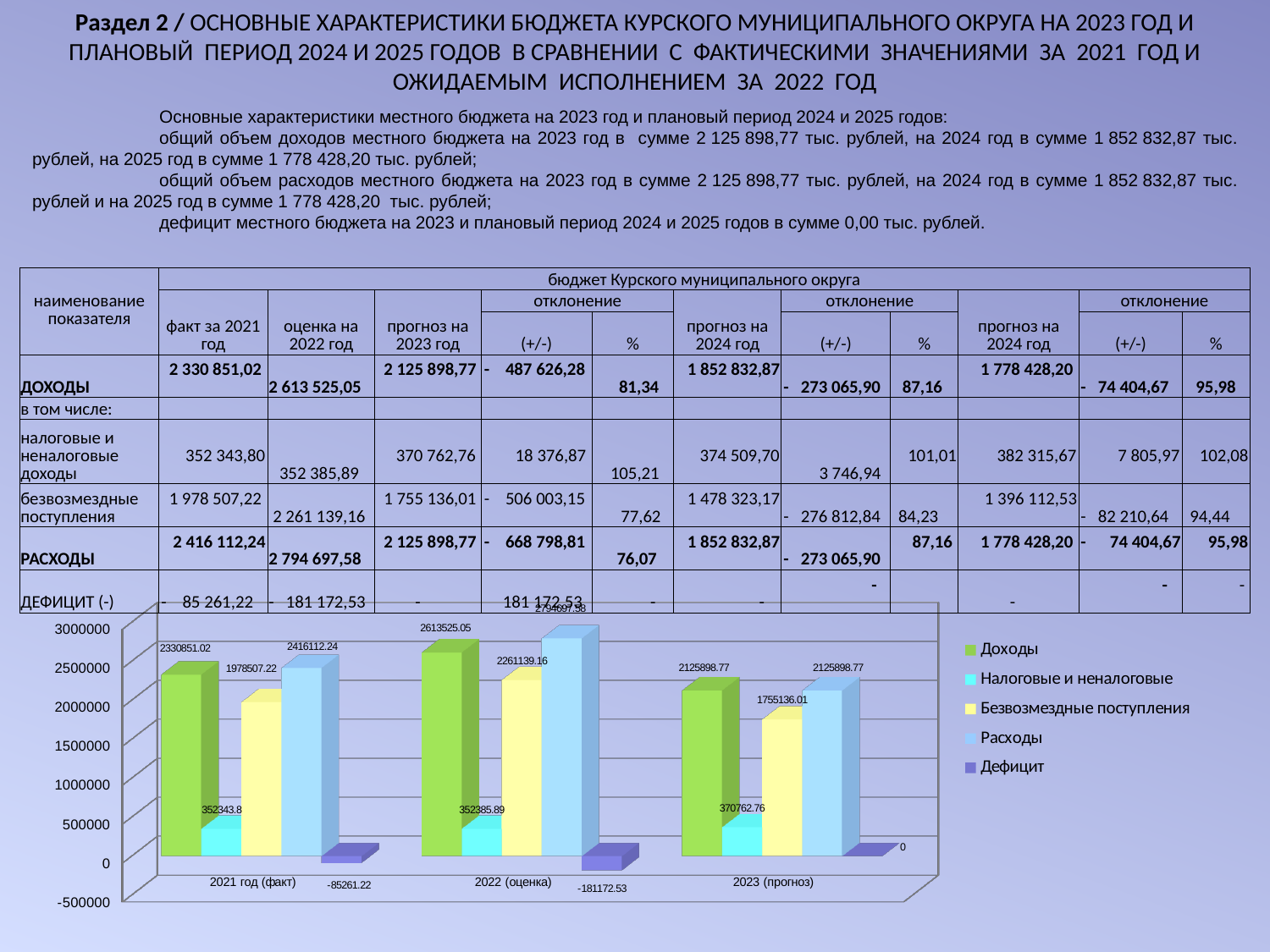
What type of chart is shown at the bottom of the slide? bar chart What is the value of Налоговые и неналоговые for 2023 (прогноз) in the chart? 370762.76 How many categories (years) are shown on the x axis of the chart? 3 Which is larger in the chart: Расходы for 2021 год (факт) or Расходы for 2023 (прогноз)? Расходы for 2021 год (факт) What is the value of Доходы for 2021 год (факт) in the chart? 2330851.02 In which year category is Безвозмездные поступления lowest in the chart? 2023 (прогноз) What is the value of Дефицит for 2023 (прогноз) in the chart? 0 In which year category is Доходы highest in the chart? 2022 (оценка) Is the value of Безвозмездные поступления for 2022 (оценка) greater or less than 2000000? greater Which legend entry in the chart is shown in green? Доходы How many series does the chart legend list? 5 What is the value of Расходы for 2022 (оценка) in the chart? 2794697.58